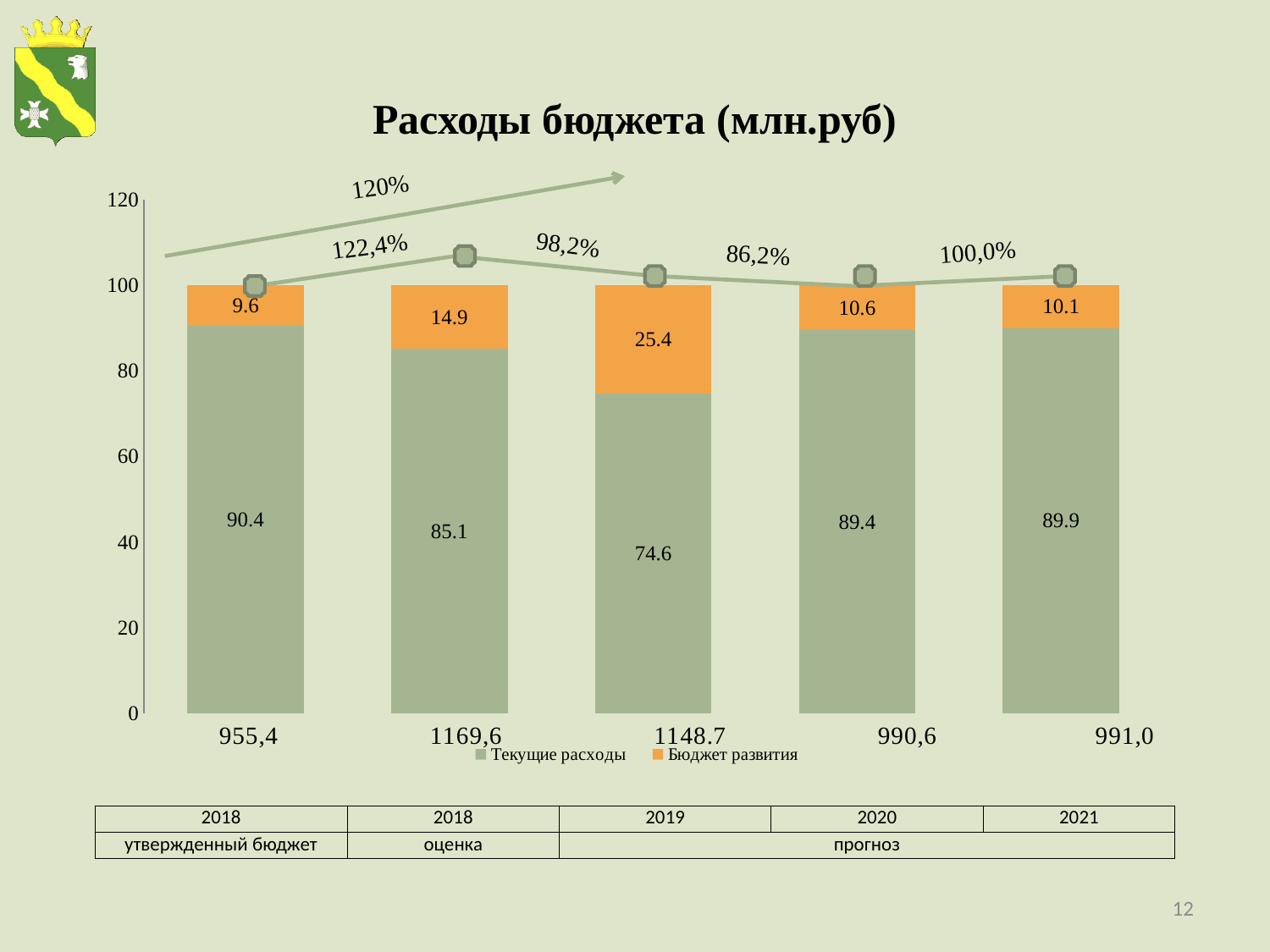
What is the value of Бюджет развития for the bar labelled 1169,6? 14.9 What is the value of Текущие расходы for the bar labelled 1148.7? 74.6 How many bars are plotted in the chart? 5 Which is larger: Бюджет развития for the bar labelled 990,6 or for the bar labelled 991,0? 990,6 What kind of chart is shown on the slide? stacked bar chart What is the title of the chart? Расходы бюджета (млн.руб) What is the value of Бюджет развития for the bar labelled 955,4? 9.6 How many series does the legend list? 2 What is the total of the stacked bar labelled 1169,6? 100 Which bar has the lowest value for Текущие расходы? 1148.7 Which bar has the highest value for Бюджет развития? 1148.7 What is the difference between Текущие расходы for the bar labelled 955,4 and the bar labelled 1148.7? 15.8